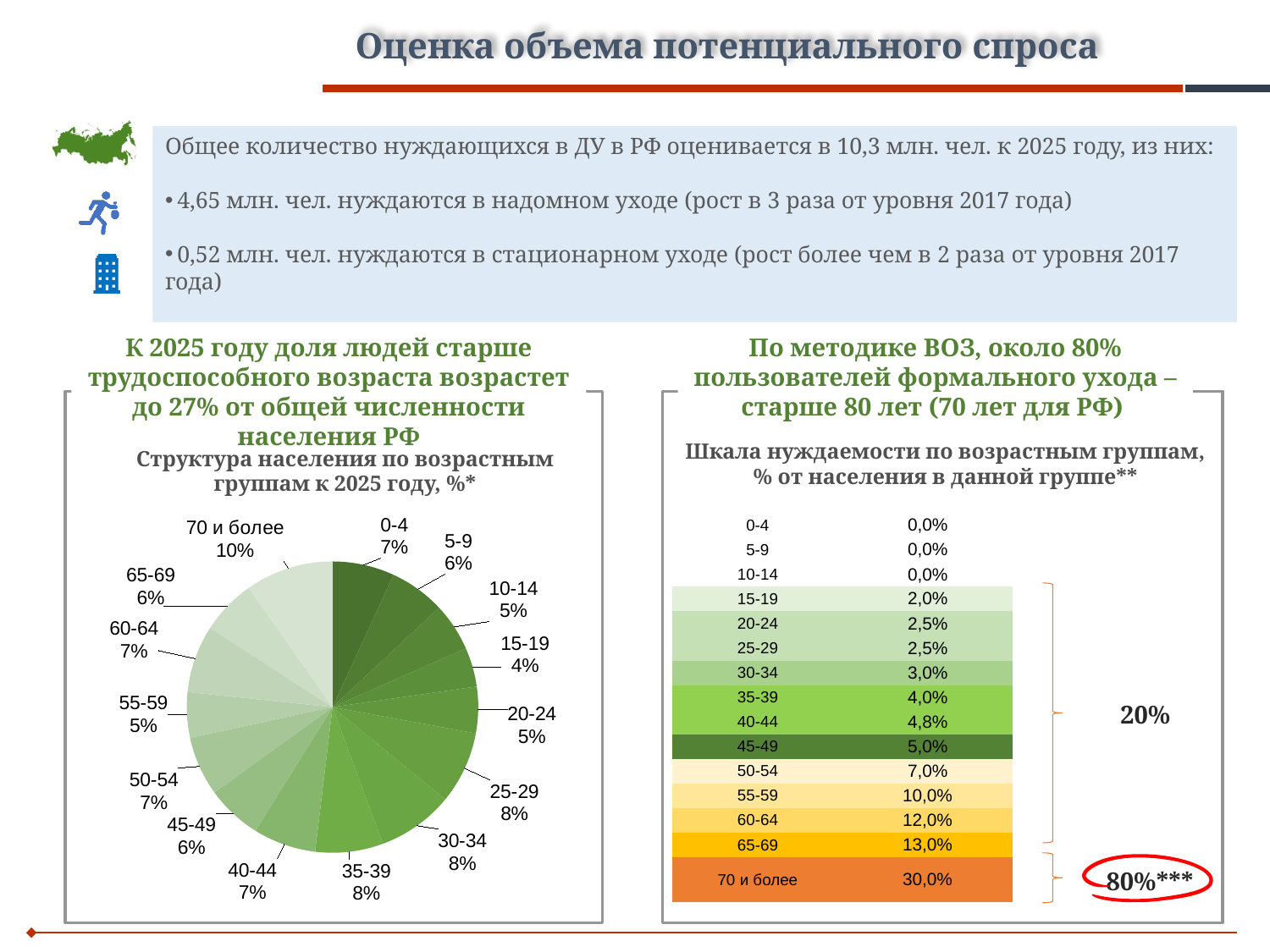
In the pie chart 'Структура населения по возрастным группам к 2025 году', what is the value for the '25-29' age group? 8% In the pie chart 'Структура населения по возрастным группам к 2025 году', what is the value for the '15-19' age group? 4% In the pie chart 'Структура населения по возрастным группам к 2025 году', what is the combined share of the '60-64' and '65-69' groups? 13% In the pie chart 'Структура населения по возрастным группам к 2025 году', which age group has the smallest share? 15-19 In the pie chart 'Структура населения по возрастным группам к 2025 году', which is larger: the share of '25-29' or the share of '0-4'? 25-29 In the table 'Шкала нуждаемости по возрастным группам' on the right, what is the value for the '45-49' group? 5,0% What type of chart is 'Структура населения по возрастным группам к 2025 году, %*'? pie chart In the table 'Шкала нуждаемости по возрастным группам' on the right, what is the value for the '70 и более' group? 30,0% In the pie chart 'Структура населения по возрастным группам к 2025 году', how many percentage points larger is the '70 и более' group than the '15-19' group? 6 In the pie chart 'Структура населения по возрастным группам к 2025 году', what share does the '70 и более' age group have? 10% How many age groups (slices) are shown in the pie chart 'Структура населения по возрастным группам к 2025 году'? 15 In the pie chart 'Структура населения по возрастным группам к 2025 году', which age group has the largest share? 70 и более